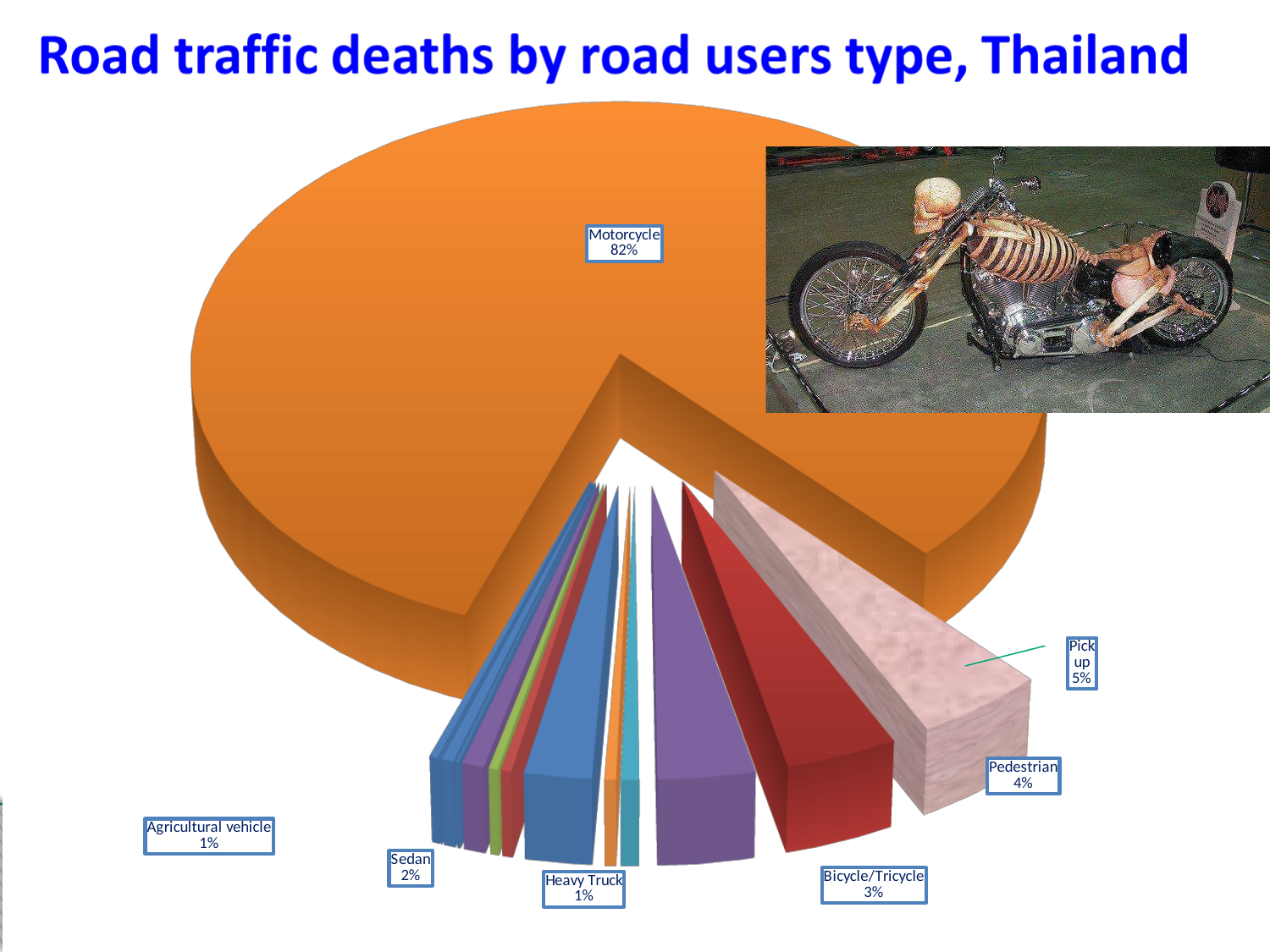
What is the difference in percentage points between the Motorcycle share and the Pick up share? 77% What share of road traffic deaths is attributed to Sedan? 2% What share of road traffic deaths is attributed to Heavy Truck? 1% What share of road traffic deaths is attributed to Pedestrian? 4% What is the title of the chart? Road traffic deaths by road users type, Thailand What share of road traffic deaths is attributed to Agricultural vehicle? 1% What share of road traffic deaths is attributed to Motorcycle? 82% What type of chart is shown on the slide? pie chart What share of road traffic deaths is attributed to Pick up? 5% Which has a larger share of road traffic deaths, Pick up or Pedestrian? Pick up Which road user type accounts for the largest share of road traffic deaths? Motorcycle What share of road traffic deaths is attributed to Bicycle/Tricycle? 3%